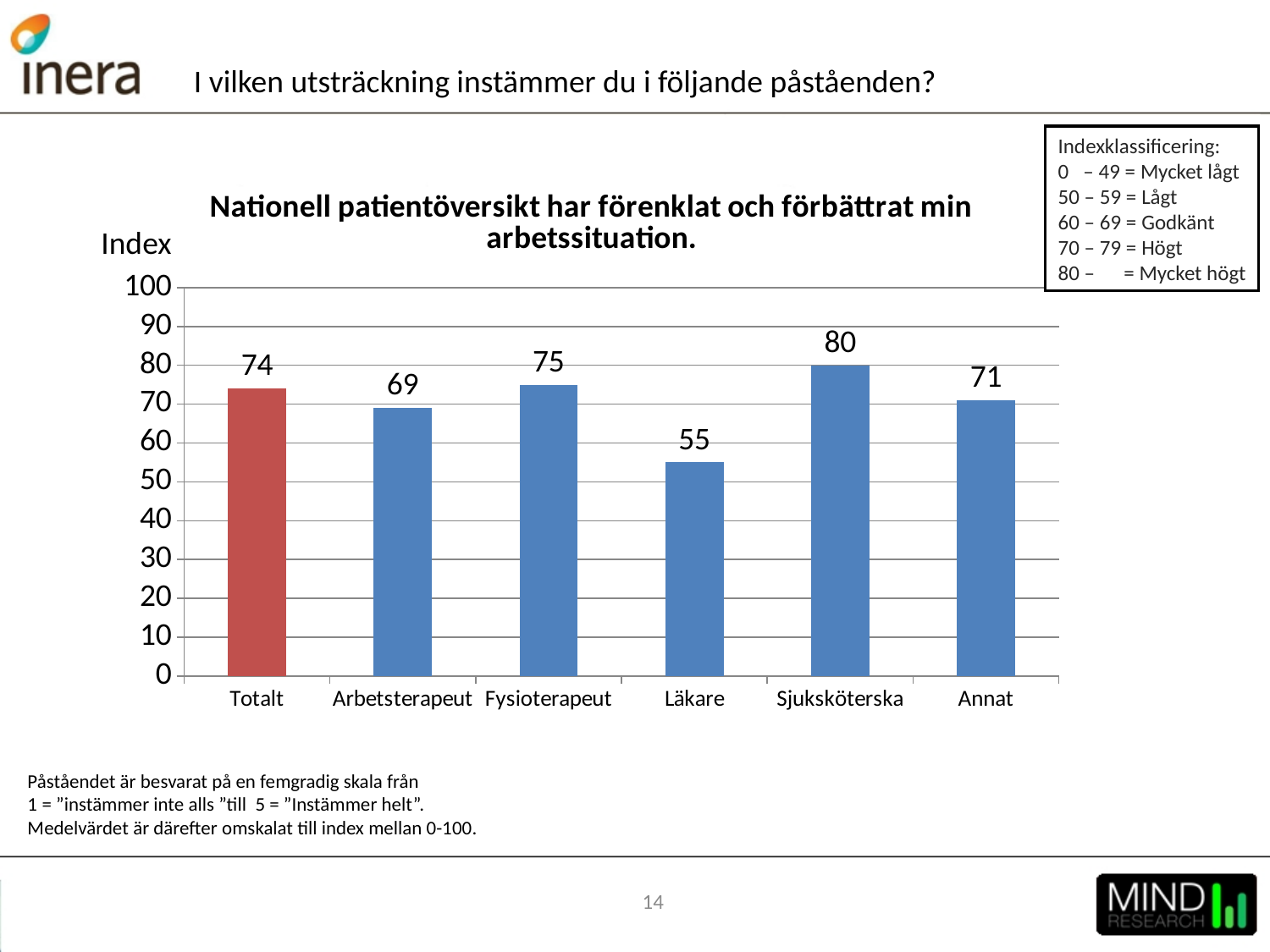
What kind of chart is shown on the slide? Bar chart What is the difference between the index values for Totalt and Arbetsterapeut? 5 Which category has the highest index value? Sjuksköterska What is the index value for Sjuksköterska? 80 What is the index value for Arbetsterapeut? 69 Which has a higher index value, Fysioterapeut or Annat? Fysioterapeut Which category has the lowest index value? Läkare How many categories are shown on the x axis? 6 What is the difference between the index values for Sjuksköterska and Läkare? 25 Which bar is shown in a different colour (red) from the others? Totalt What is the index value for Totalt? 74 What is the index value for Läkare? 55